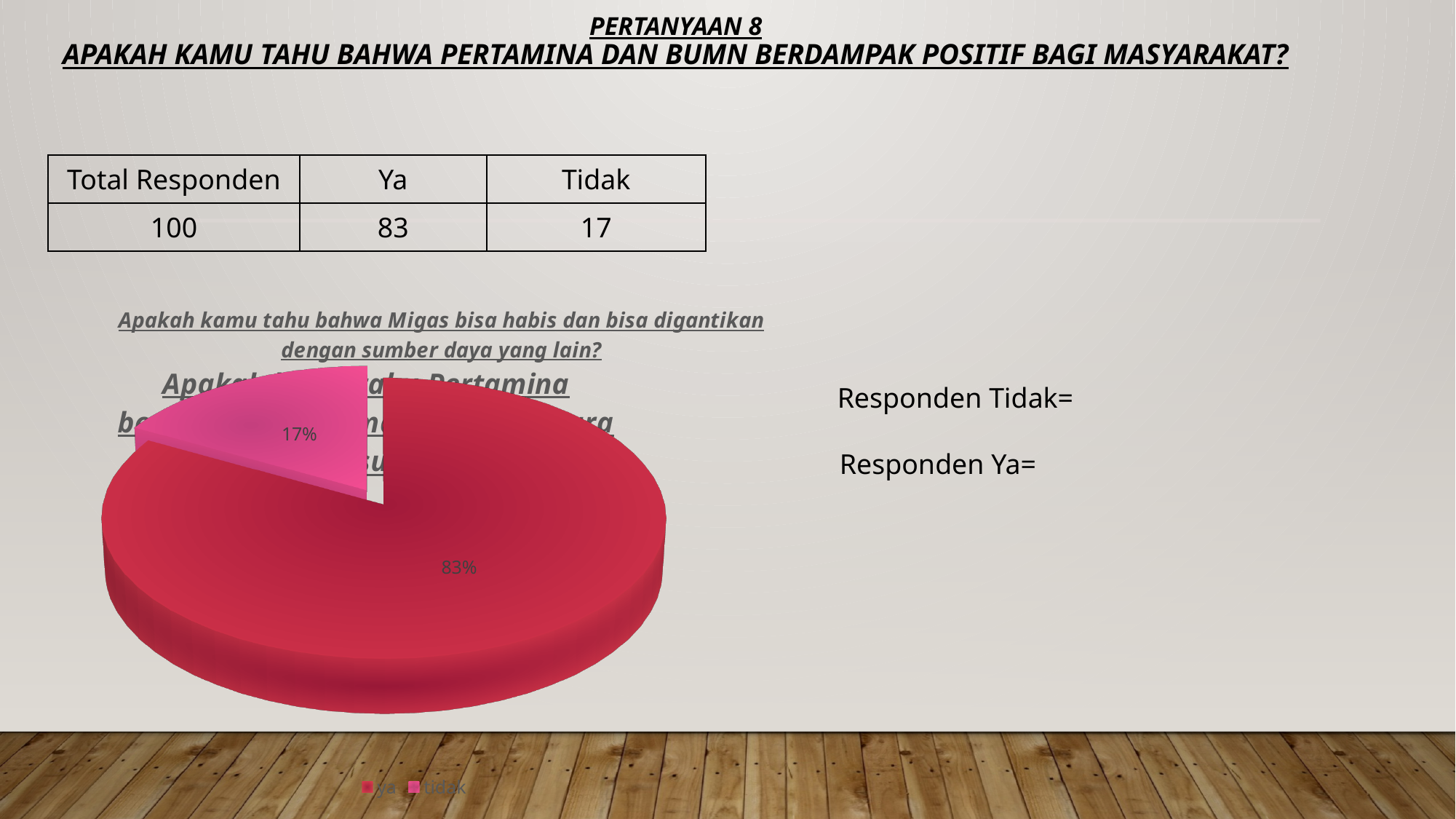
Which is larger in the pie chart, "ya" or "tidak"? ya What kind of chart is shown on the slide? pie chart How many slices does the pie chart have? 2 What percentage of the pie chart is the "ya" slice? 83% What are the two entries in the pie chart's legend? ya, tidak Which slice of the pie chart is the smallest? tidak What colour is the "tidak" slice in the pie chart? pink What is the difference in percentage points between the "ya" and "tidak" slices? 66 What percentage of the pie chart is the "tidak" slice? 17% Which slice of the pie chart is the largest? ya How many entries does the pie chart's legend list? 2